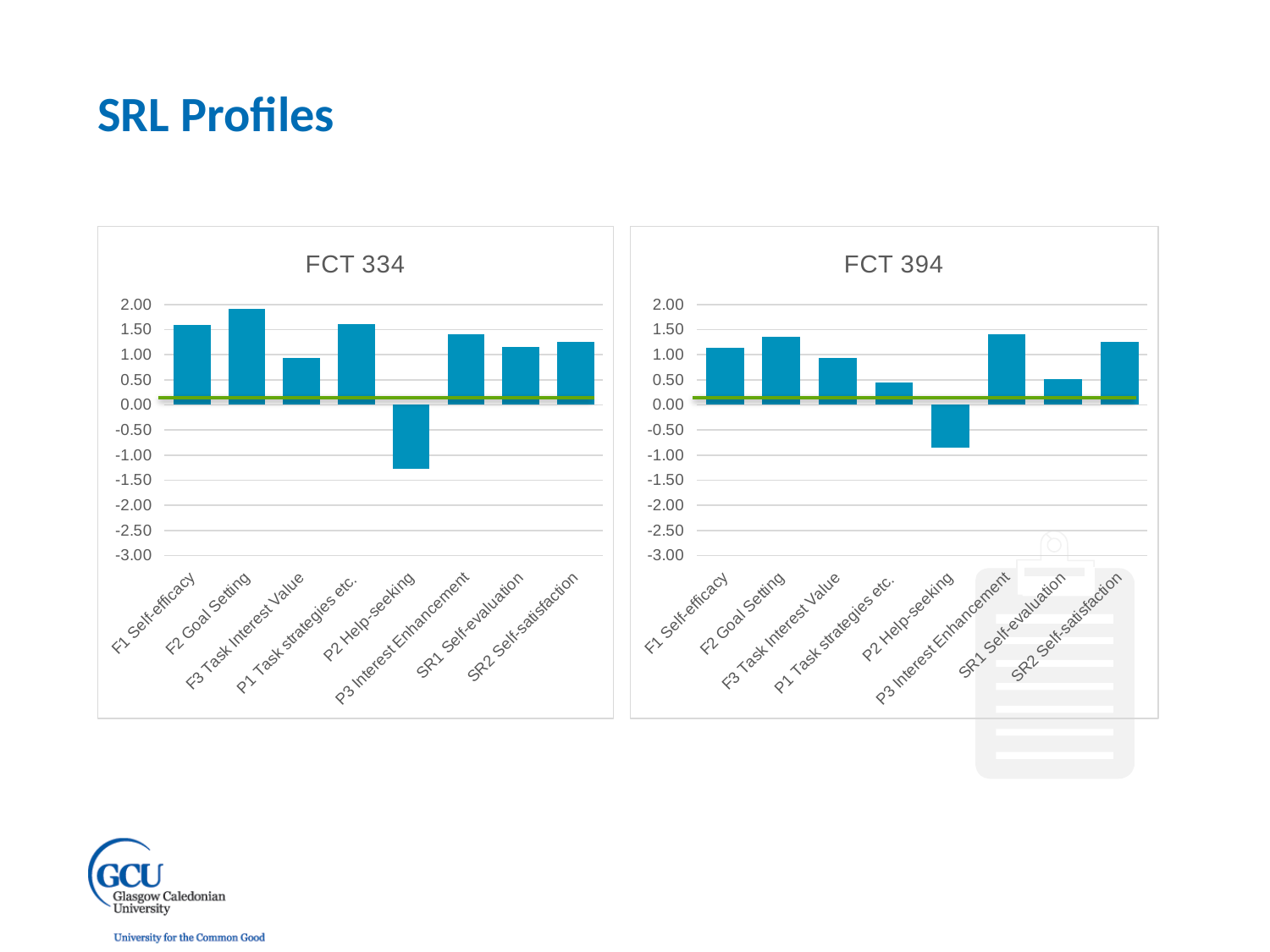
What kind of chart is the FCT 334 chart? bar chart In the FCT 394 chart, which is larger, the value for F2 Goal Setting or P1 Task strategies etc.? F2 Goal Setting In the FCT 394 chart, is the value for F1 Self-efficacy greater or less than 1.00? greater In the FCT 394 chart, which category has the lowest value? P2 Help-seeking In the FCT 334 chart, is the value for F2 Goal Setting greater or less than 1.50? greater How many categories are shown on the x axis of the FCT 394 chart? 8 In the FCT 394 chart, is the value for P2 Help-seeking greater or less than -1.00? greater In the FCT 334 chart, which category has the lowest value? P2 Help-seeking What is the title of the chart on the right of the slide? FCT 394 In the FCT 334 chart, which is larger, the value for F2 Goal Setting or F3 Task Interest Value? F2 Goal Setting In the FCT 334 chart, which category has the highest value? F2 Goal Setting